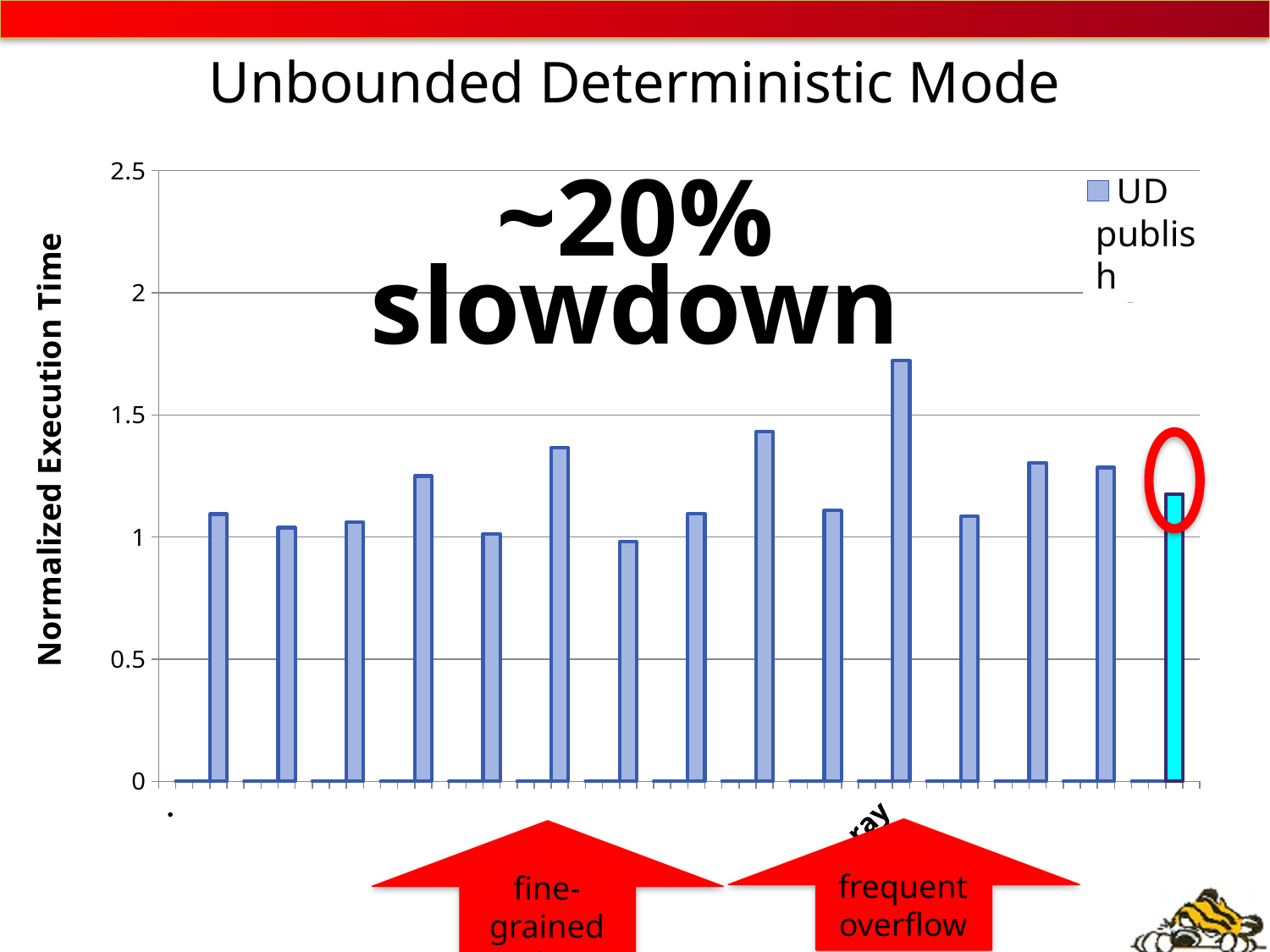
Is the value of the rightmost (cyan, circled) bar greater or less than 1.5? less Is the value of the fourth bar from the left greater or less than 1? greater Is the value of the rightmost (cyan, circled) bar greater or less than 1? greater How many bars are plotted in the chart? 15 Which bar is the tallest in the chart, counting from the left? the eleventh bar Which is larger, the value of the ninth bar from the left or the value of the tenth bar from the left? the ninth bar What kind of chart is shown on the slide? bar chart What is the title of the chart's vertical axis? Normalized Execution Time How many series does the chart legend list? 1 What is the highest tick value shown on the vertical axis? 2.5